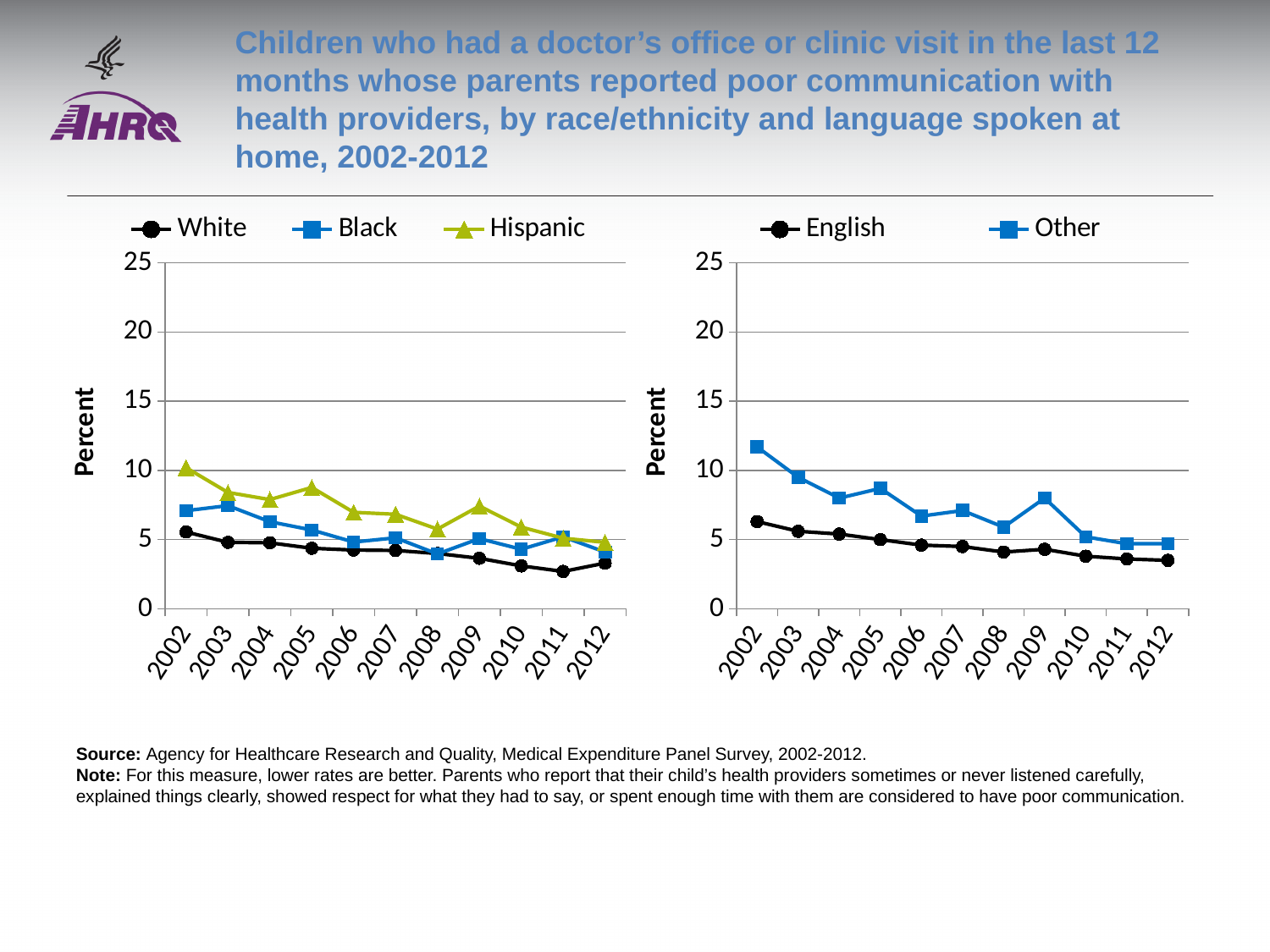
In the left chart, which series has the highest value in 2002? Hispanic What kind of chart is the left chart (by race/ethnicity)? line chart In the right chart, which is larger in 2002, English or Other? Other What is the label on the vertical axis of the left chart? Percent In the left chart, does the White series rise or fall from 2002 to 2012? fall In the right chart, does the Other series rise or fall from 2002 to 2012? fall How many series does the legend of the right chart list? 2 In the right chart, is the value for Other in 2002 greater or less than 10? greater How many years are plotted along the x axis of the right chart? 11 In the left chart, is the value for White in 2012 greater or less than 5? less In the left chart, is the value for Hispanic in 2005 greater or less than 5? greater How many series does the legend of the left chart list? 3